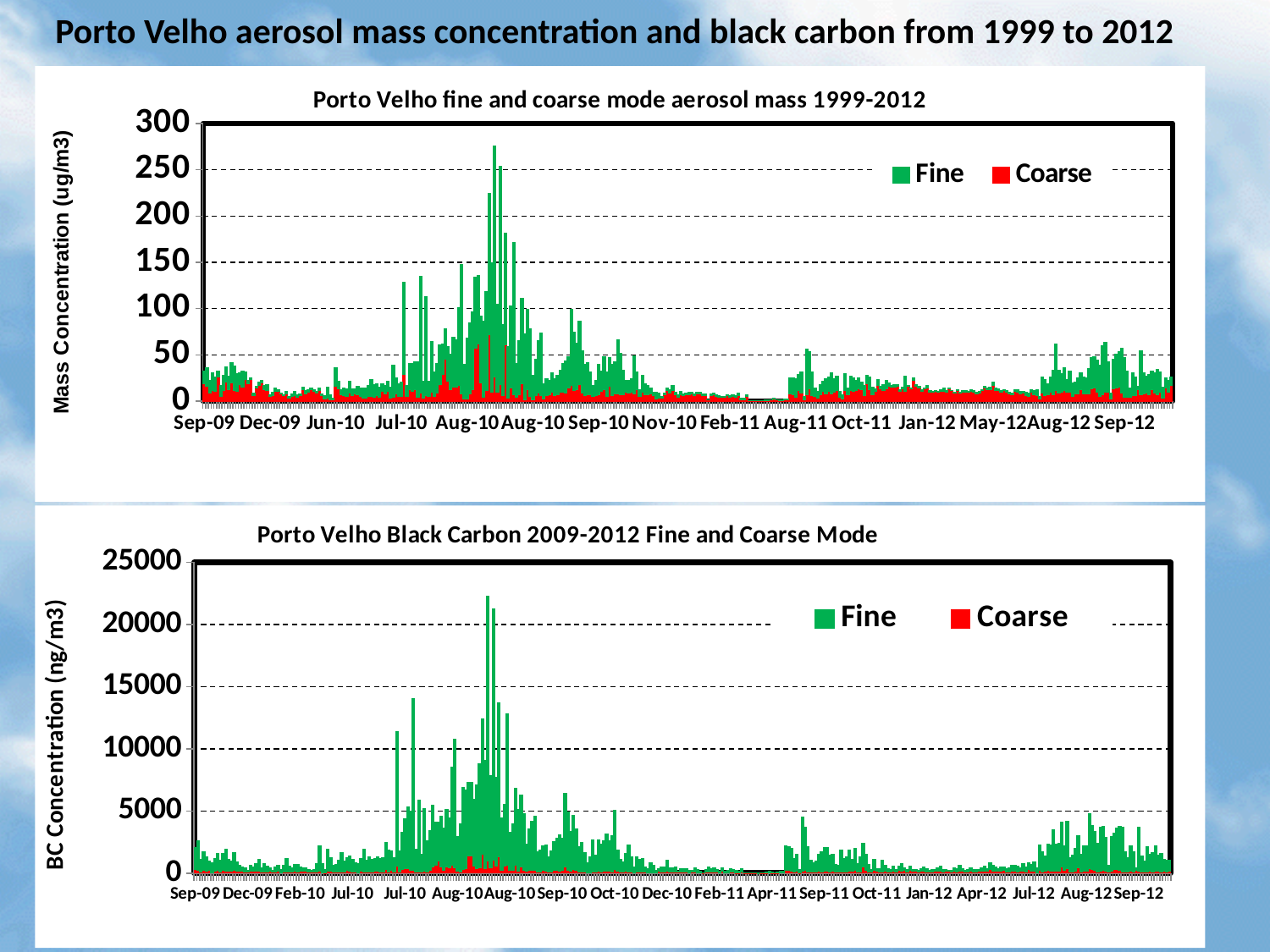
In the bottom chart, which series reaches higher values, Fine or Coarse? Fine What are the two series named in the legend of the bottom chart, 'Porto Velho Black Carbon 2009-2012 Fine and Coarse Mode'? Fine and Coarse In the bottom chart, is the Coarse value around Aug-10 greater or less than 5000? less In the top chart, which series reaches higher values, Fine or Coarse? Fine How many series does the legend of the top chart list? 2 What kind of chart is the bottom chart? bar chart What kind of chart is the top chart, 'Porto Velho fine and coarse mode aerosol mass 1999-2012'? bar chart In the bottom chart, is the highest Fine peak (around Aug-10) greater or less than 20000? greater What is the maximum value shown on the y axis of the bottom chart? 25000 In the top chart, which series is shown in green? Fine In the top chart, is the Fine value around Feb-11 greater or less than 50? less